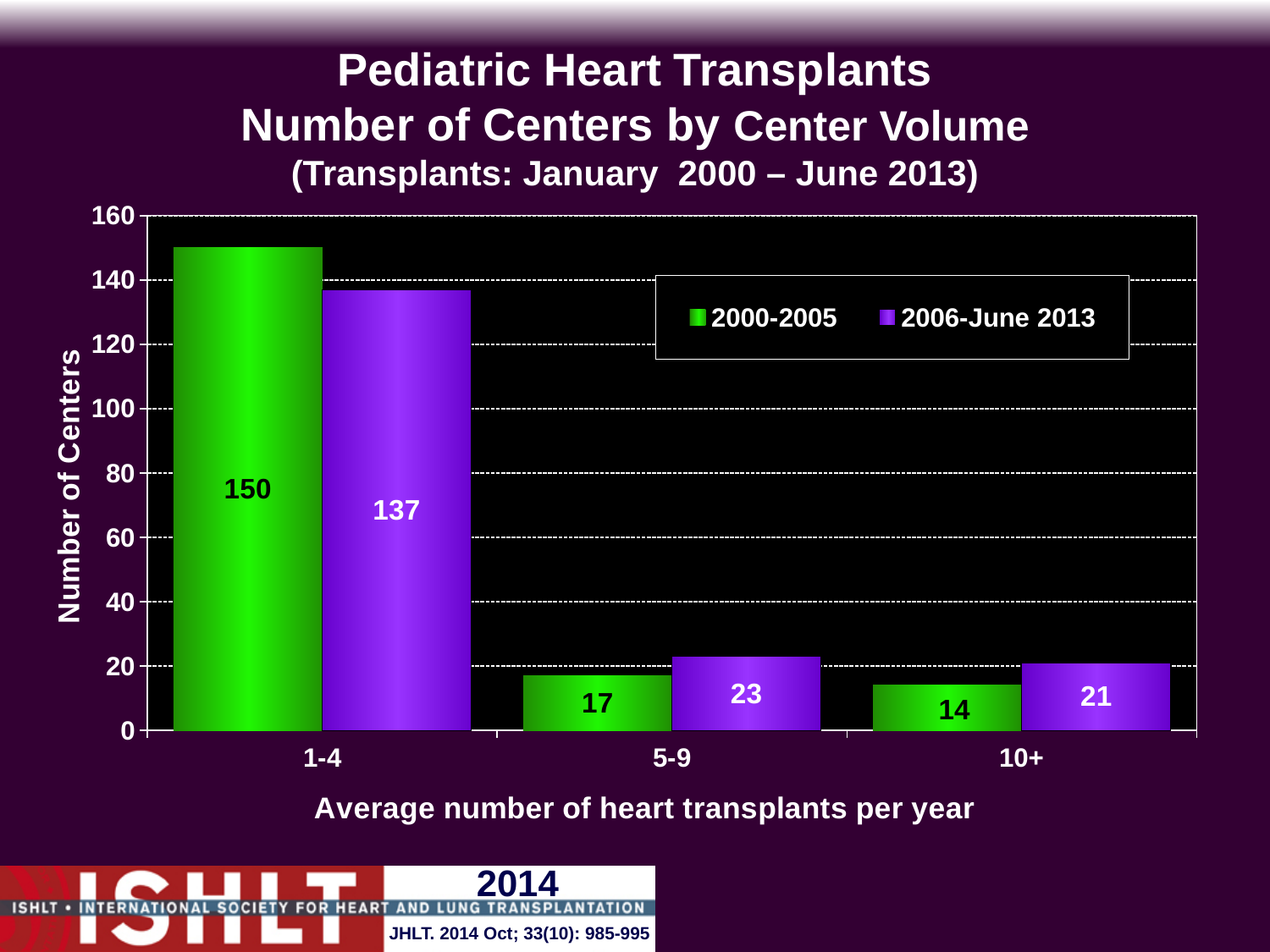
How many series does the legend list? 2 What is the number of centers in the 5-9 category for 2006-June 2013? 23 How many categories are shown on the x axis? 3 Which category has the lowest number of centers for 2000-2005? 10+ What is the number of centers in the 1-4 category for 2000-2005? 150 What is the label of the y axis? Number of Centers Is the value for 2006-June 2013 in the 1-4 category greater or less than 120? greater In the 10+ category, which series has the larger value, 2000-2005 or 2006-June 2013? 2006-June 2013 What is the number of centers in the 10+ category for 2000-2005? 14 What kind of chart is shown on the slide? bar chart Which category has the highest number of centers for 2006-June 2013? 1-4 What is the difference between the 2000-2005 and 2006-June 2013 values in the 1-4 category? 13